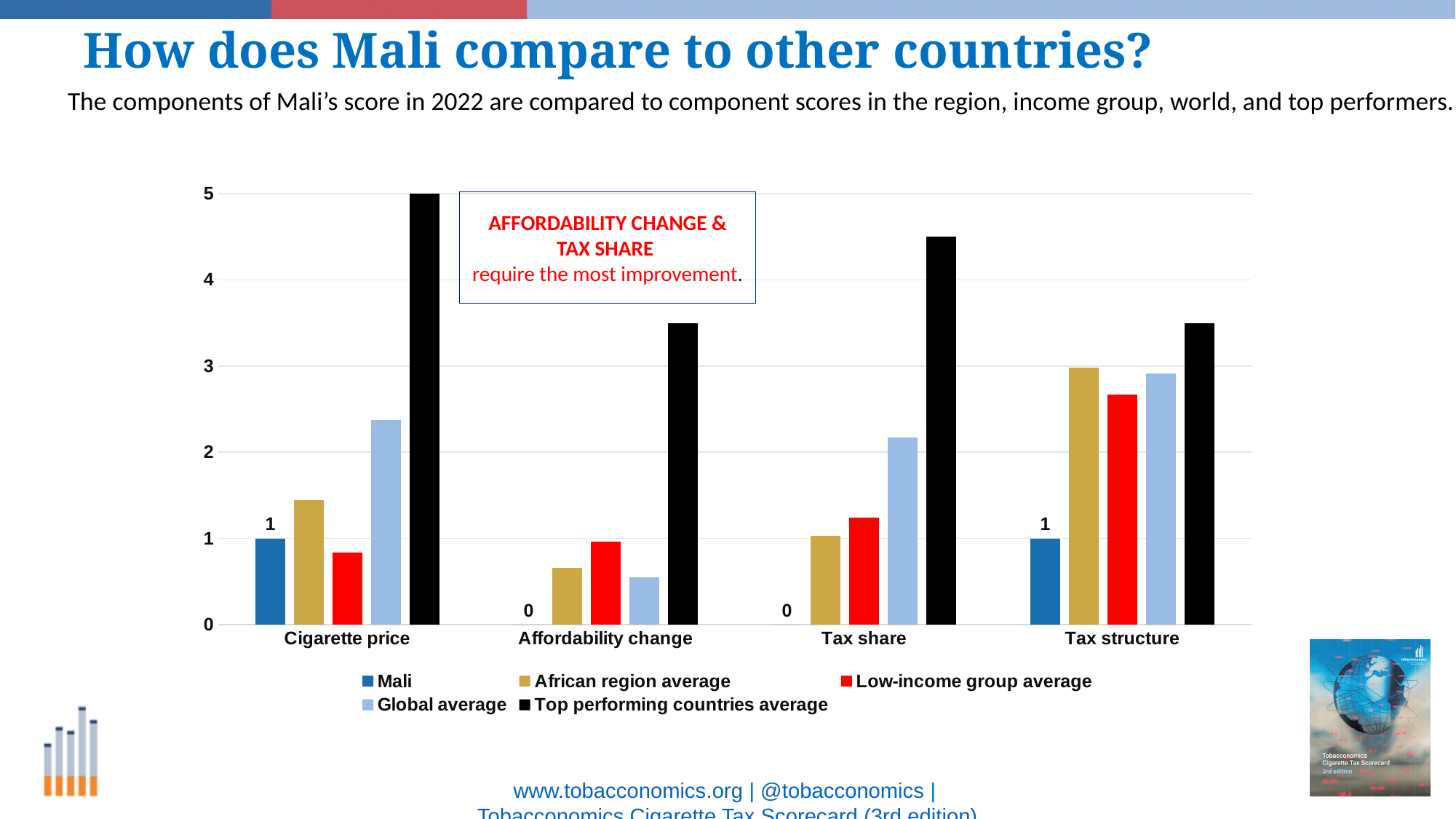
Is the Global average for Cigarette price greater or less than 2? greater What is Mali's score for Tax share? 0 What is Mali's score for Affordability change? 0 Is the Global average for Affordability change greater or less than 1? less What is the Top performing countries average score for Cigarette price? 5 How many component categories are shown on the x axis? 4 Is the Top performing countries average for Tax share greater or less than 4? greater Which series has the highest score for Tax structure? Top performing countries average What is Mali's score for Cigarette price? 1 How many series does the legend list? 5 What kind of chart is shown on the slide? Bar chart What is Mali's score for Tax structure? 1